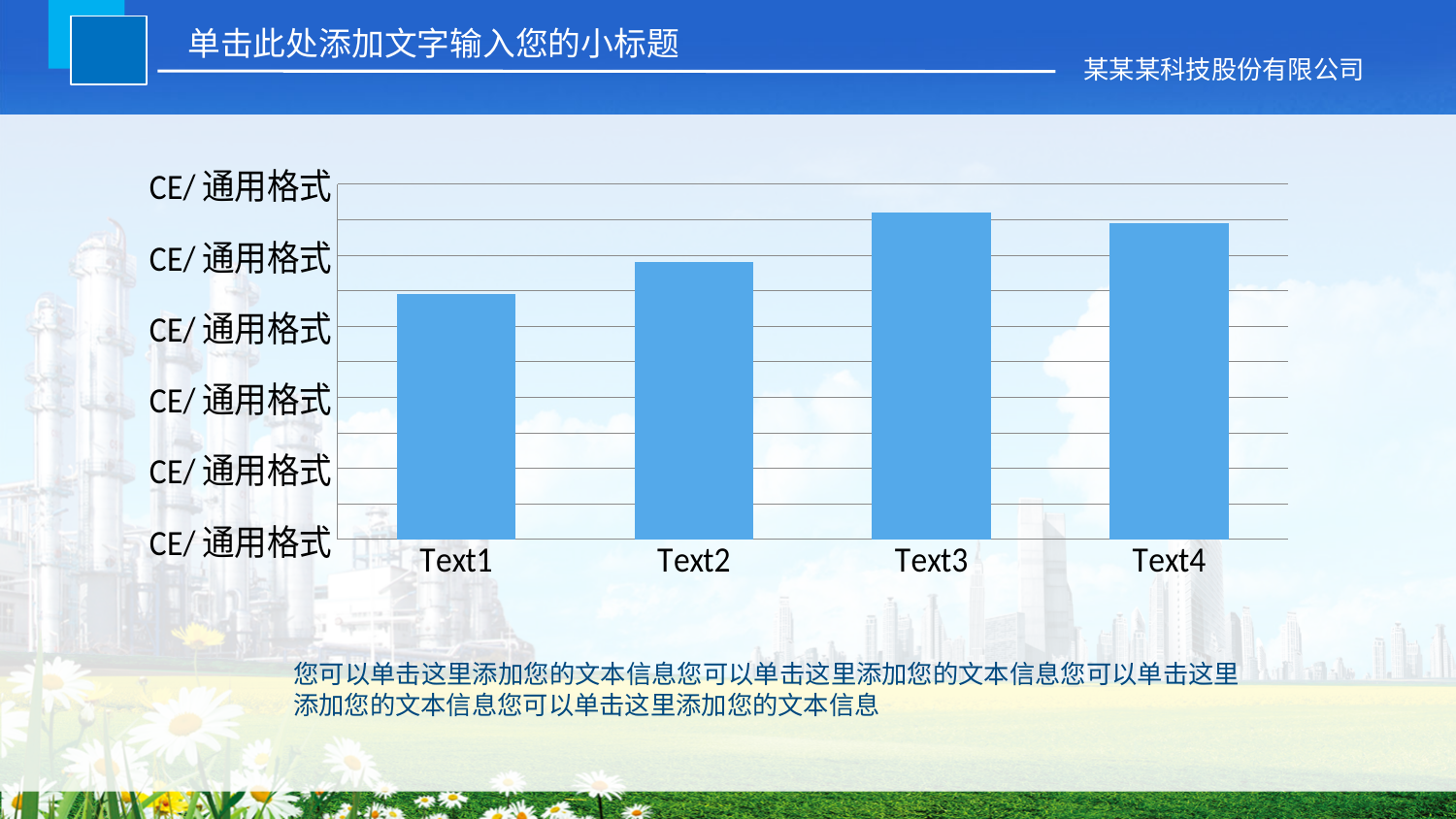
What kind of chart is shown on the slide? bar chart What colour are the bars in the chart? blue Which bar is taller, Text2 or Text4? Text4 How many categories are shown on the x axis of the chart? 4 Which category has the shortest bar in the chart? Text1 Which bar is taller, Text1 or Text2? Text2 Which bar is taller, Text1 or Text4? Text4 What is the label of the first category on the x axis? Text1 Which category has the tallest bar in the chart? Text3